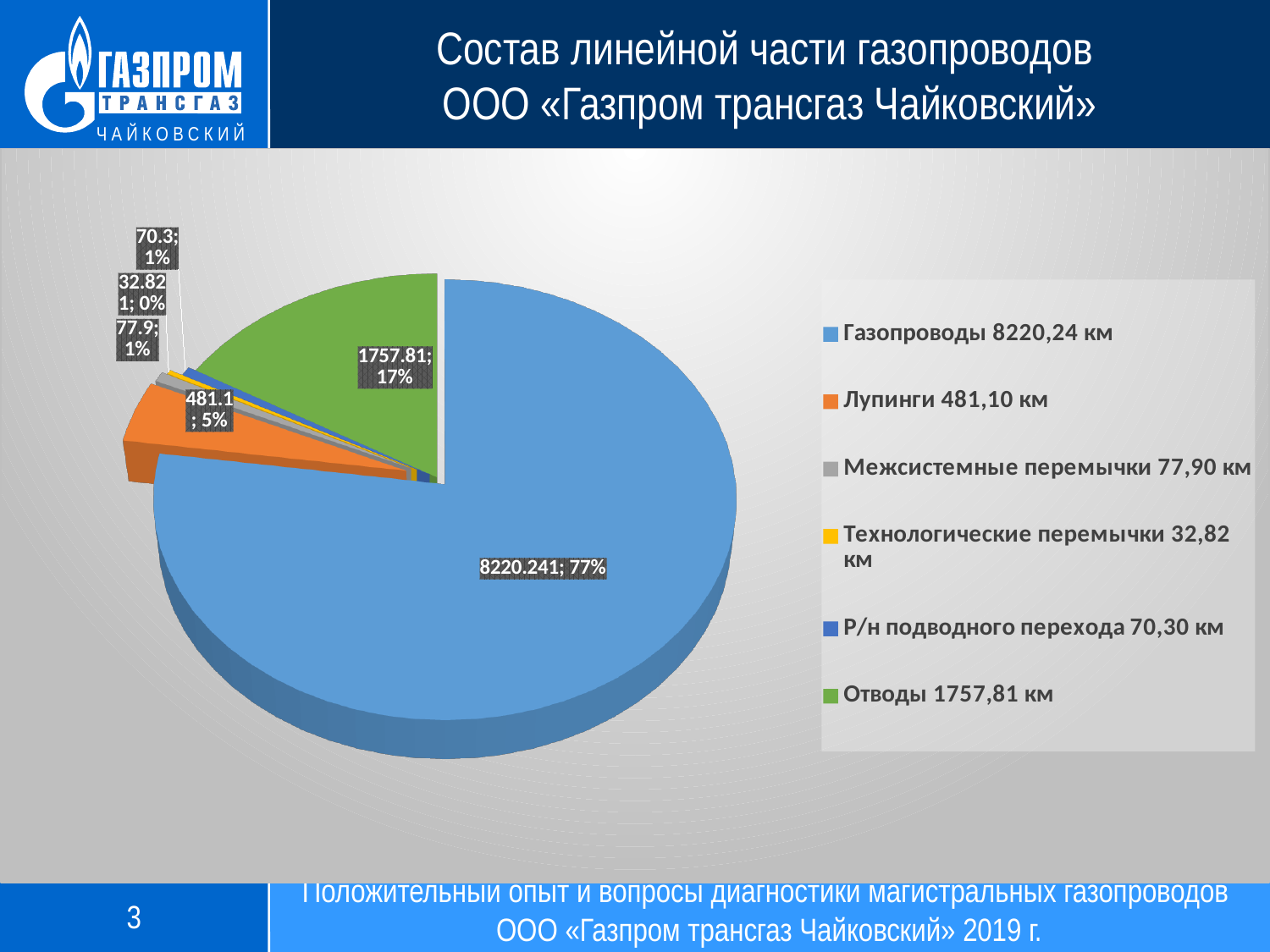
How many slices does the pie chart have? 6 What share of the pie does Отводы take? 17% What share of the pie does Газопроводы take? 77% Which category has the smallest slice of the pie? Технологические перемычки How many entries does the legend list? 6 Which is larger, Межсистемные перемычки or Р/н подводного перехода? Межсистемные перемычки Which category has the largest slice of the pie? Газопроводы What value is labelled on the Лупинги slice? 481.1 What value is labelled on the Отводы slice? 1757.81 What is the difference between the Отводы value (1757.81) and the Лупинги value (481.1)? 1276.71 What kind of chart is shown on the slide? Pie chart What share of the pie does Лупинги take? 5%